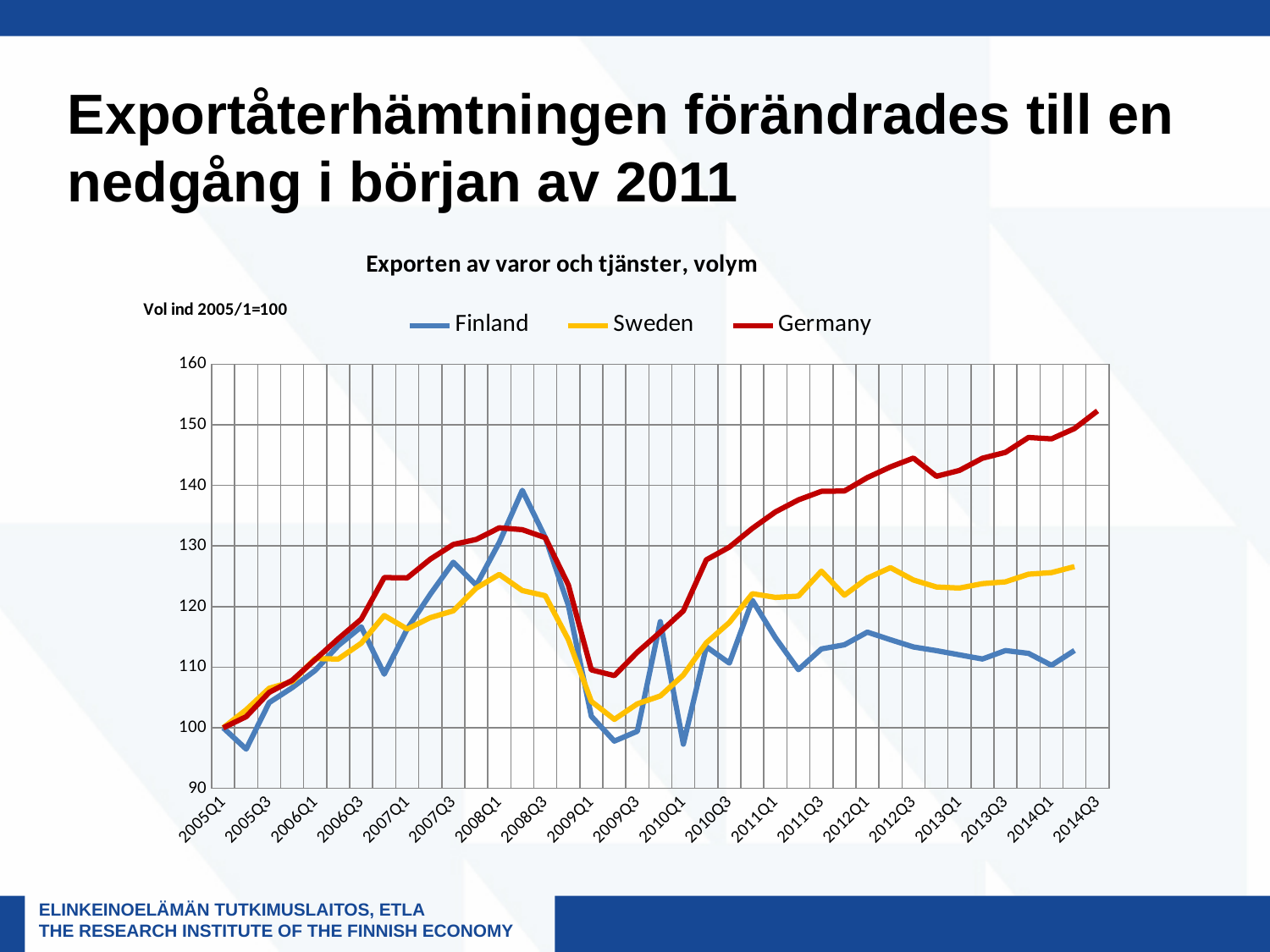
Is the value for Germany at 2014Q3 greater or less than 140? greater At 2008Q3, which is larger: the value for Finland or the value for Sweden? Finland Which colour is used for the Germany line? red What is the title of the chart? Exporten av varor och tjänster, volym What kind of chart is shown on the slide? line chart Does the Germany line rise or fall from 2011Q1 to 2014Q3? rise Is the value for Sweden at 2009Q3 greater or less than 110? less Which series has the highest value at 2014Q3? Germany How many series does the chart legend list? 3